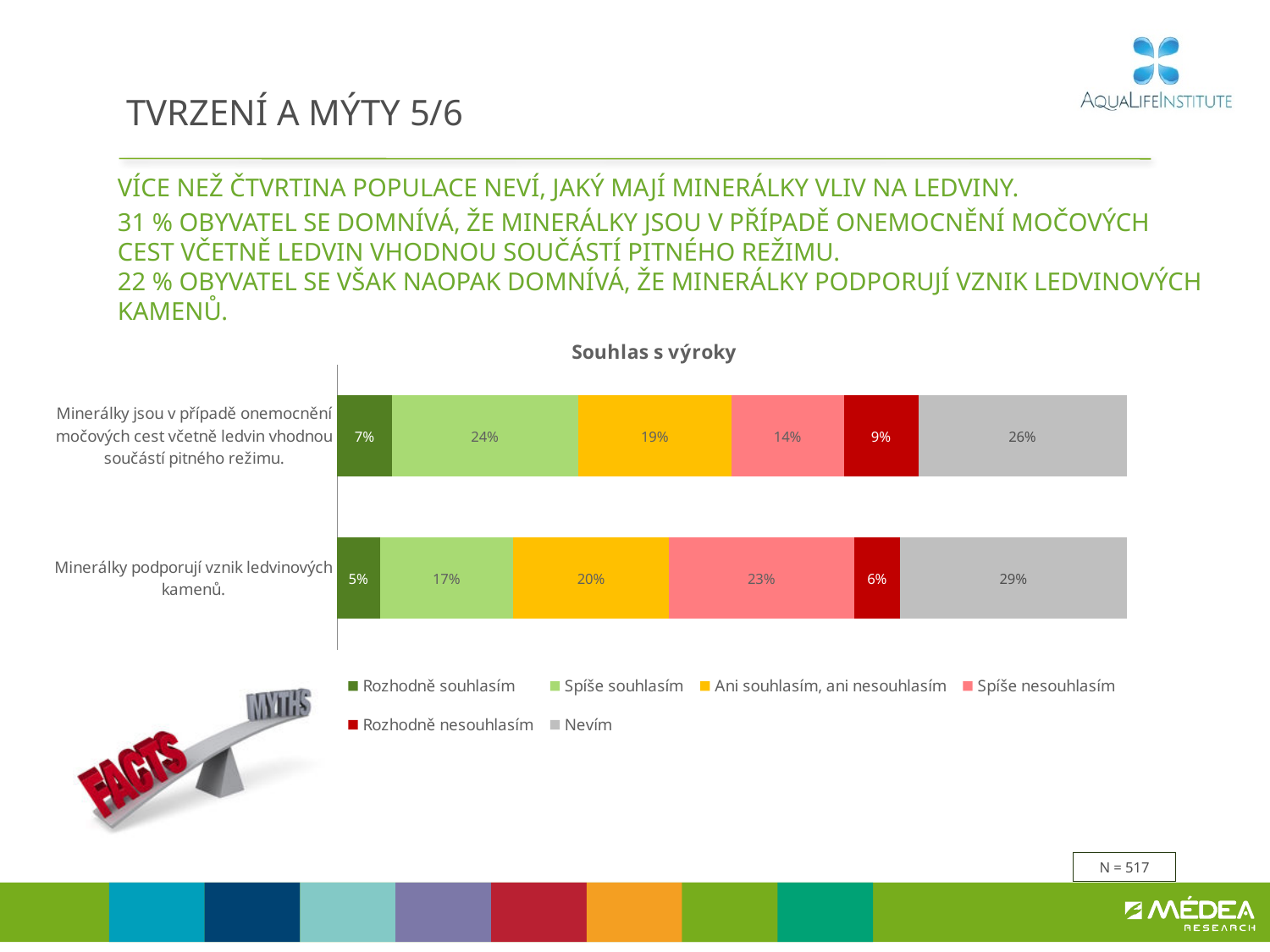
Which statement has the higher "Rozhodně souhlasím" value? Minerálky jsou v případě onemocnění močových cest včetně ledvin vhodnou součástí pitného režimu. What is the value of "Rozhodně nesouhlasím" for the statement "Minerálky jsou v případě onemocnění močových cest včetně ledvin vhodnou součástí pitného režimu."? 9% Which response has the smallest share for the statement "Minerálky podporují vznik ledvinových kamenů."? Rozhodně souhlasím What is the difference between the "Spíše souhlasím" values of the two statements? 7% Which response has the largest share for the statement "Minerálky jsou v případě onemocnění močových cest včetně ledvin vhodnou součástí pitného režimu."? Nevím What is the value of "Nevím" for the statement "Minerálky podporují vznik ledvinových kamenů."? 29% What is the title of the chart? Souhlas s výroky What is the value of "Spíše nesouhlasím" for the statement "Minerálky podporují vznik ledvinových kamenů."? 23% What is the value of "Spíše souhlasím" for the statement "Minerálky jsou v případě onemocnění močových cest včetně ledvin vhodnou součástí pitného režimu."? 24% How many series does the chart legend list? 6 What kind of chart is shown on the slide? stacked bar chart How many statements (categories) are plotted in the chart? 2